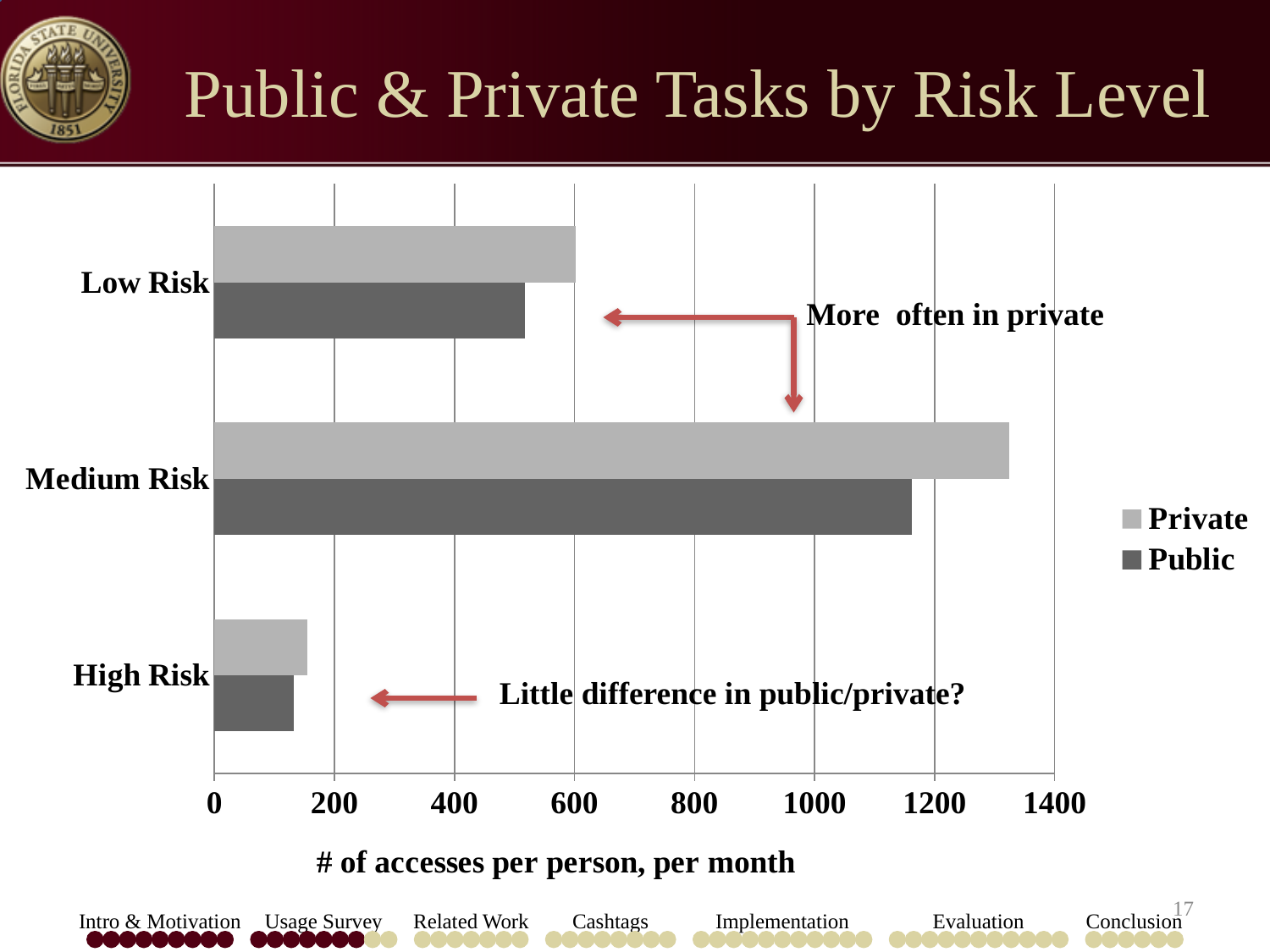
What is the label of the horizontal axis? # of accesses per person, per month Which risk level has the highest Private value? Medium Risk Is the Public value for Medium Risk greater or less than 1200? less How many series does the legend list? 2 Is the Public value for Low Risk greater or less than 400? greater Is the Private value for Medium Risk greater or less than 1200? greater What kind of chart is shown on the slide? bar chart For Low Risk, which is larger, the Private value or the Public value? Private Which risk level has the lowest Public value? High Risk How many risk-level categories are shown on the chart? 3 For Medium Risk, which is larger, the Private value or the Public value? Private